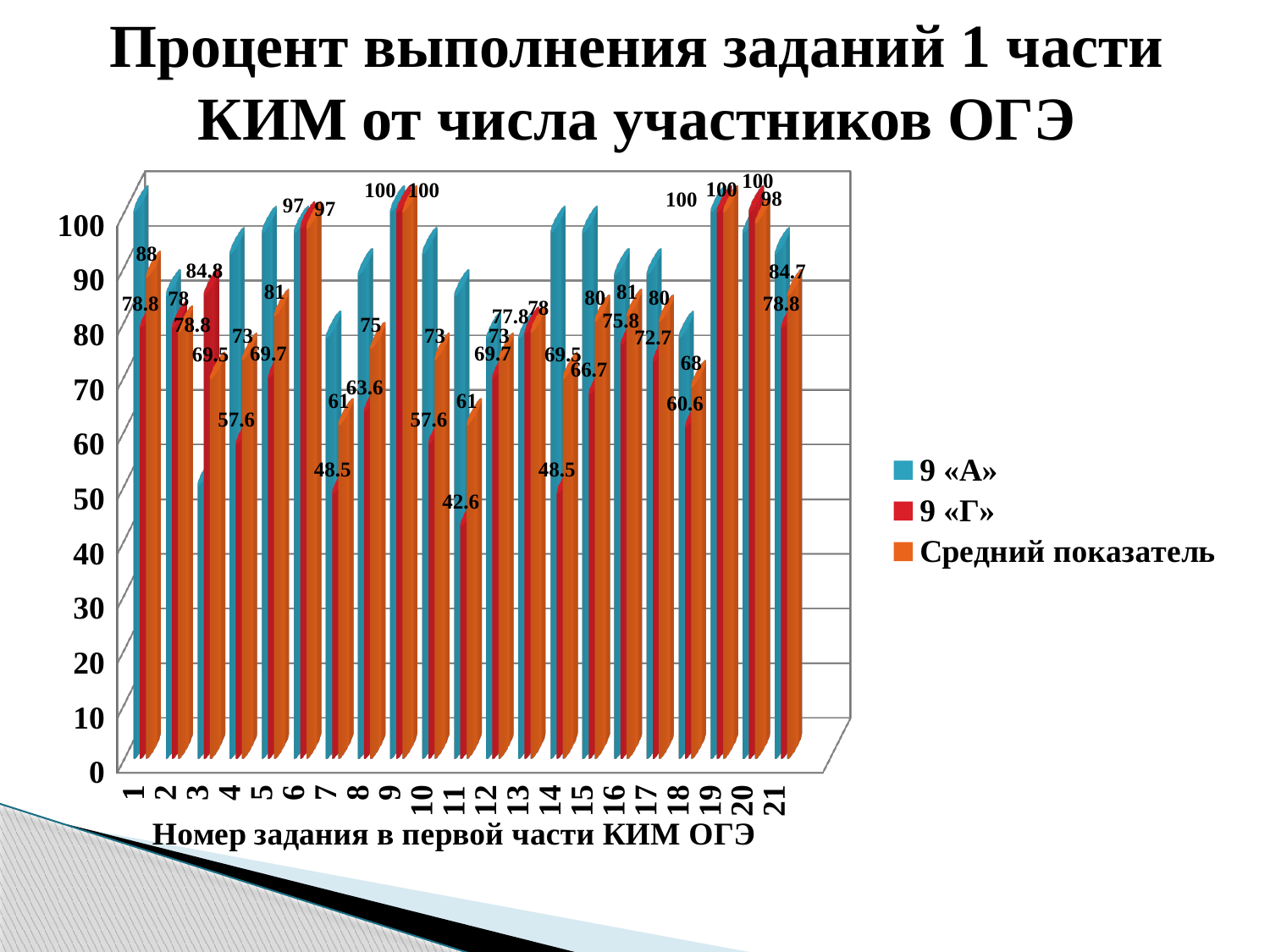
What are the three series listed in the legend? 9 «А», 9 «Г», Средний показатель What is the value for 9 «Г» for task 11? 42.6 What is the difference between the 9 «Г» value and the Средний показатель value for task 20? 2 For which task is the value for 9 «Г» the lowest? 11 What is the value for Средний показатель for task 20? 98 What is the difference between the Средний показатель value and the 9 «Г» value for task 11? 18.4 For task 7, which is larger: the value for 9 «Г» or for Средний показатель? Средний показатель How many series does the legend list? 3 What kind of chart is shown on the slide? bar chart What is the value for 9 «Г» for task 3? 84.8 How many task numbers are shown along the x axis? 21 What is the x-axis title of the chart? Номер задания в первой части КИМ ОГЭ